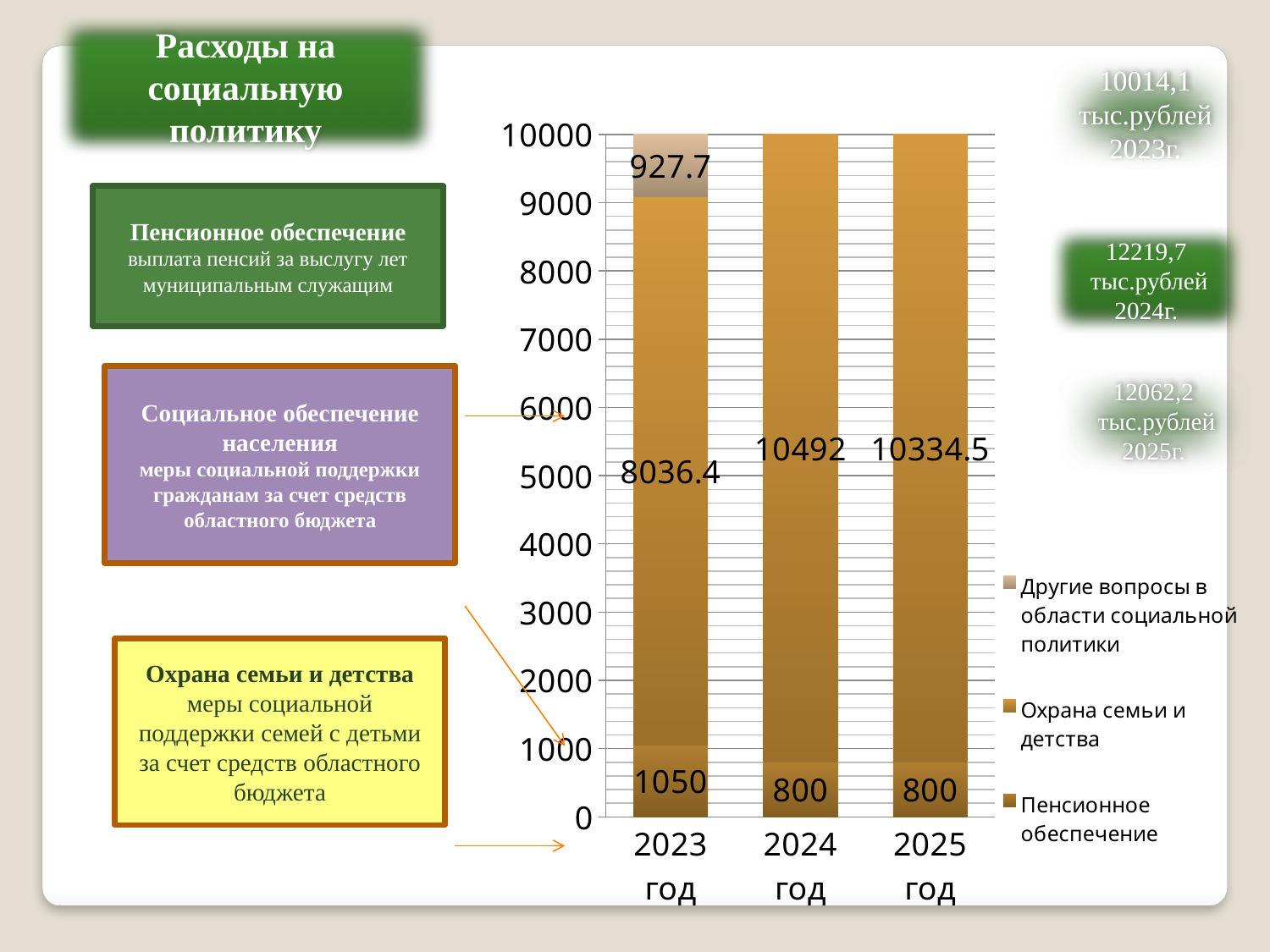
What is the value for Охрана семьи и детства in 2025 год? 10334.5 What is the value for Другие вопросы в области социальной политики in 2023 год? 927.7 Which is larger, the Охрана семьи и детства value for 2023 год or for 2024 год? 2024 год How many series does the chart legend list? 3 How many year categories are shown on the x axis of the chart? 3 What is the value for Охрана семьи и детства in 2024 год? 10492 What is the value for Пенсионное обеспечение in 2023 год? 1050 What is the difference between the Охрана семьи и детства values for 2024 год and 2025 год? 157.5 What is the total of the stacked bar for 2023 год? 10014.1 In which year is the Охрана семьи и детства value the highest? 2024 год What is the difference between the Пенсионное обеспечение values for 2023 год and 2024 год? 250 What kind of chart is shown on the slide? Stacked bar chart